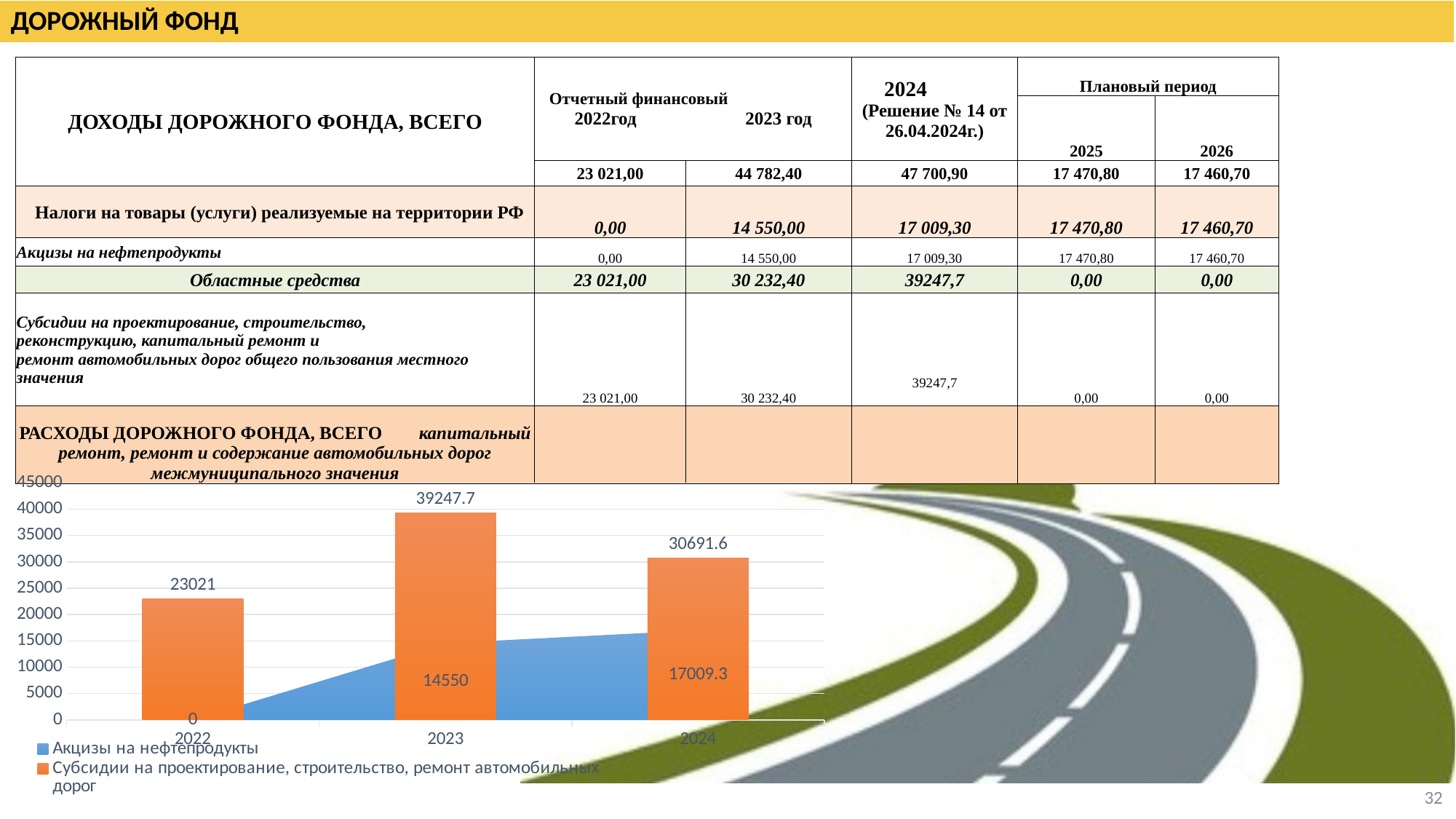
What is the value of the Субсидии series for 2024? 30691.6 Is the Субсидии value for 2022 greater or less than 25000? less What is the value of the Субсидии на проектирование, строительство, ремонт автомобильных дорог series for 2023? 39247.7 What is the value of the Акцизы на нефтепродукты series for 2022? 0 In which year is the Акцизы на нефтепродукты series lowest? 2022 What is the value of the Акцизы на нефтепродукты series for 2024? 17009.3 Which is larger in 2024: the Субсидии value or the Акцизы на нефтепродукты value? Субсидии Does the Акцизы на нефтепродукты series rise or fall from 2022 to 2024? rise In which year is the Субсидии series highest? 2023 What is the difference between the Субсидии values for 2023 and 2024? 8556.1 How many years are shown on the x axis of the chart? 3 How many series does the chart legend list? 2